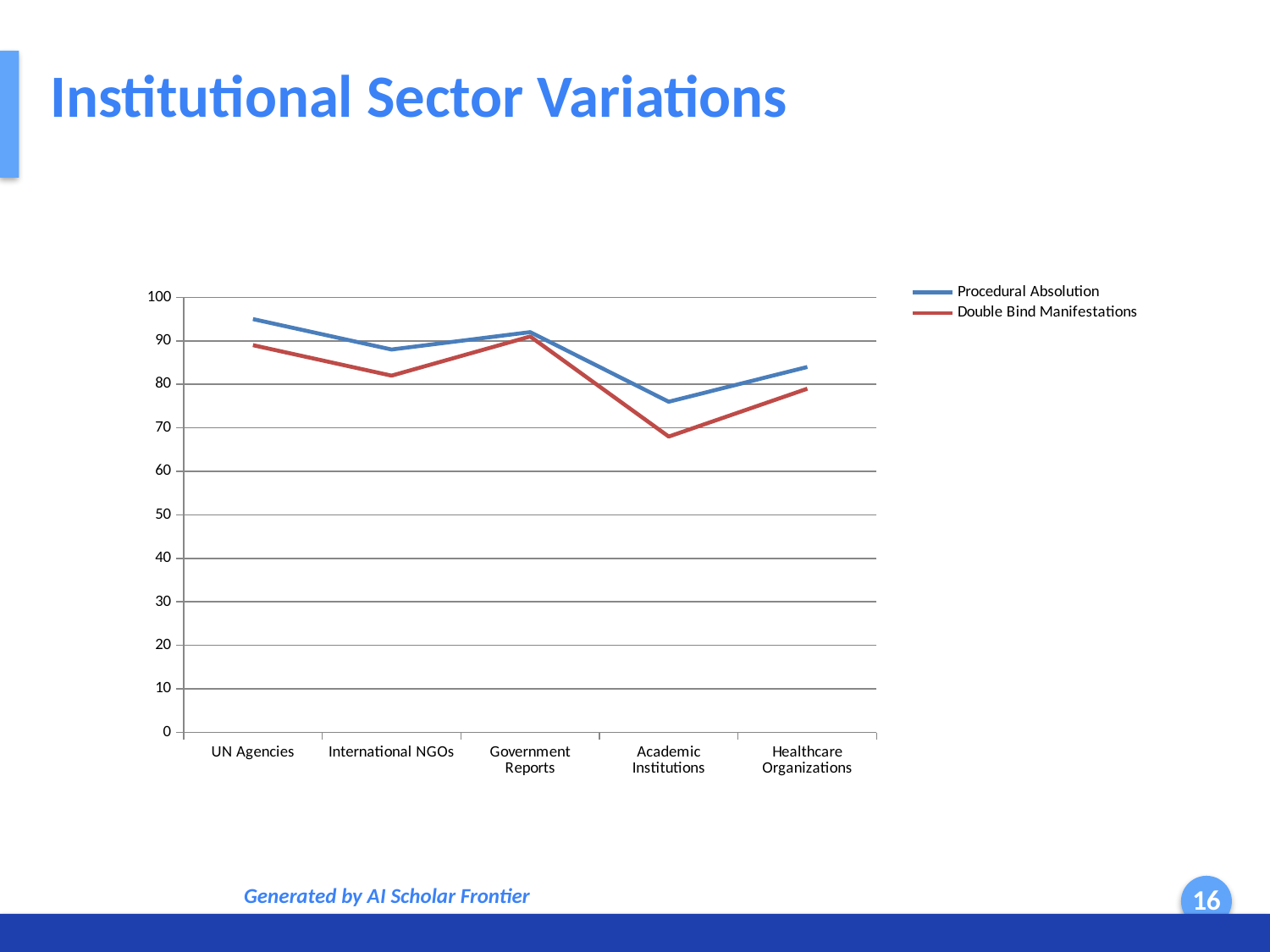
Is the value for Procedural Absolution at Academic Institutions greater or less than 80? less At International NGOs, which series has the higher value, Procedural Absolution or Double Bind Manifestations? Procedural Absolution How many categories are shown on the x axis? 5 Is the value for Double Bind Manifestations at Healthcare Organizations greater or less than 70? greater What is the title of the slide containing the chart? Institutional Sector Variations Which category has the lowest value for Double Bind Manifestations? Academic Institutions How many series does the legend list? 2 Does the Procedural Absolution line rise or fall from Government Reports to Academic Institutions? fall Is the value for Double Bind Manifestations at Academic Institutions greater or less than 80? less Which category has the lowest value for Procedural Absolution? Academic Institutions What kind of chart is shown on the slide? Line chart